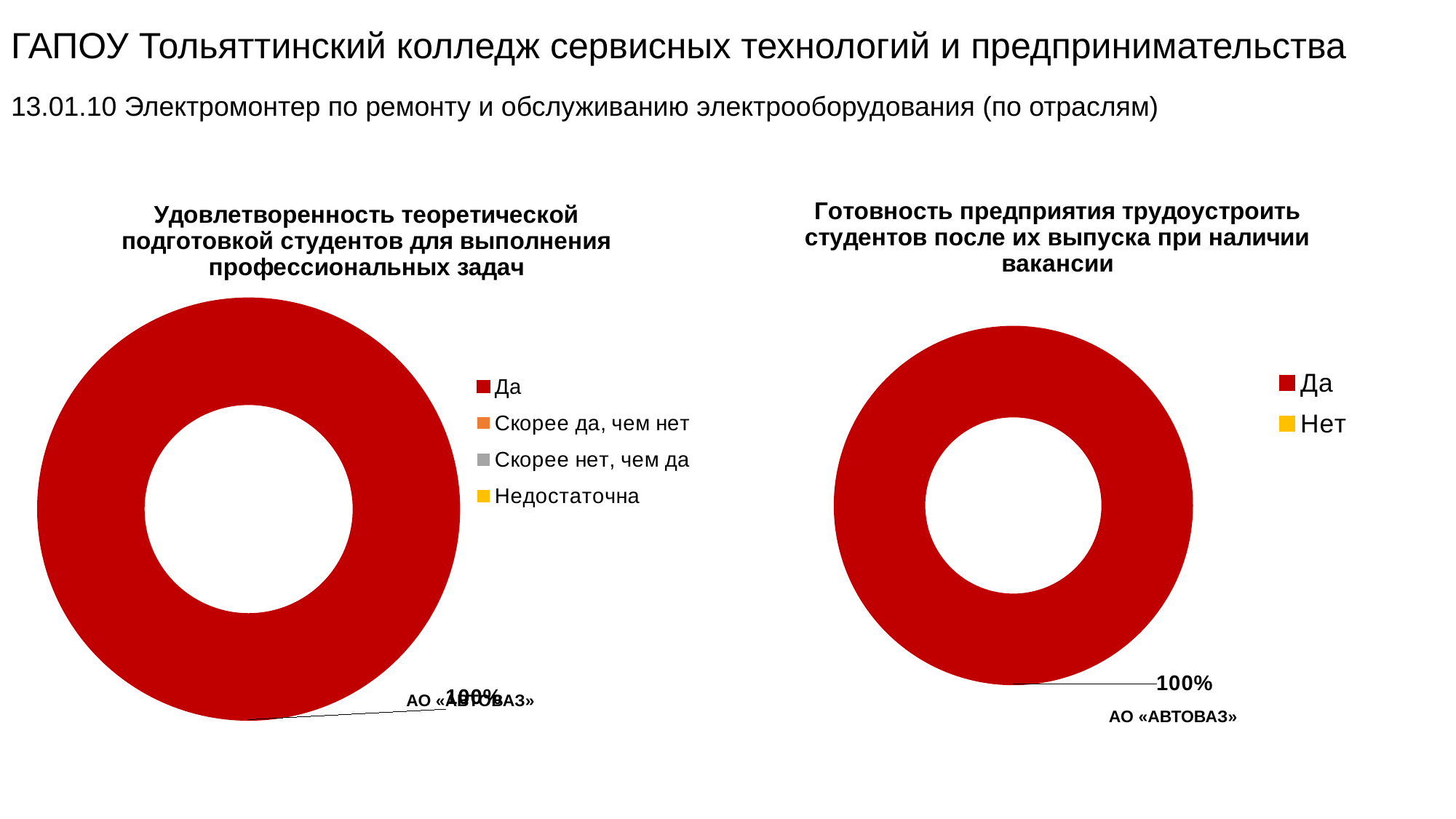
Which enterprise is named in the data label of the right chart (Готовность предприятия трудоустроить студентов)? АО «АВТОВАЗ» In the left chart (Удовлетворенность теоретической подготовкой студентов), which category accounts for the largest share? Да In the left chart (Удовлетворенность теоретической подготовкой студентов), what share does the "Да" slice have? 100% What kind of chart is the left chart titled "Удовлетворенность теоретической подготовкой студентов для выполнения профессиональных задач"? Doughnut (pie) chart How many entries does the legend of the right chart (Готовность предприятия трудоустроить студентов) list? 2 In the right chart (Готовность предприятия трудоустроить студентов), what share does the "Да" slice have? 100% How many entries does the legend of the left chart (Удовлетворенность теоретической подготовкой студентов) list? 4 In the right chart (Готовность предприятия трудоустроить студентов), is the share for "Да" greater or less than 50%? greater In the right chart (Готовность предприятия трудоустроить студентов), what colour does the legend assign to "Нет"? Yellow What kind of chart is the right chart titled "Готовность предприятия трудоустроить студентов после их выпуска при наличии вакансии"? Doughnut (pie) chart In the right chart (Готовность предприятия трудоустроить студентов), which category accounts for the largest share? Да